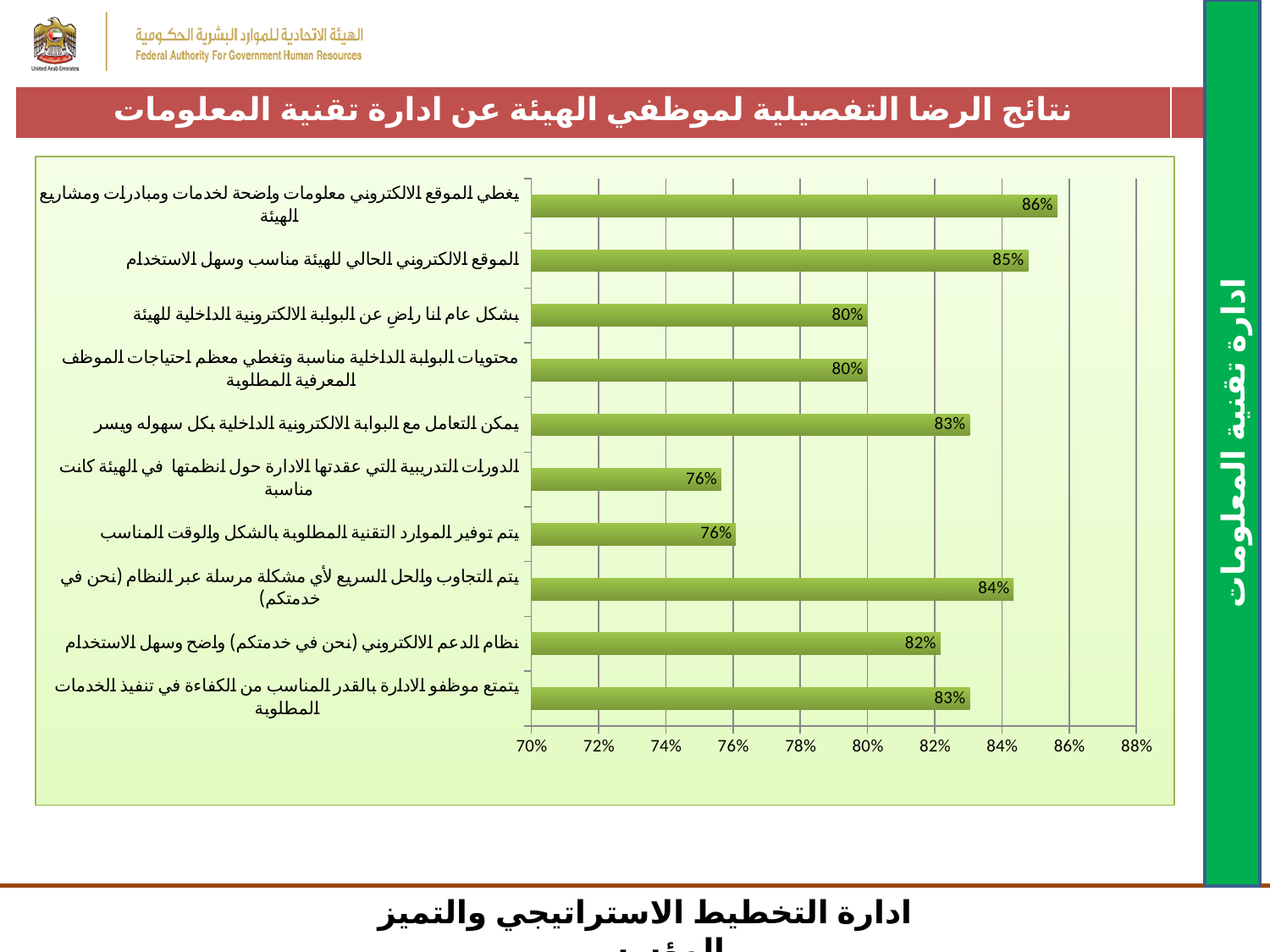
What is the difference between the value for "يغطي الموقع الالكتروني معلومات واضحة لخدمات ومبادرات ومشاريع الهيئة" and the value for "يتم توفير الموارد التقنية المطلوبة بالشكل والوقت المناسب"? 10% Which is larger: the value for "يمكن التعامل مع البوابة الالكترونية الداخلية بكل سهوله ويسر" or the value for "نظام الدعم الالكتروني (نحن في خدمتكم) واضح وسهل الاستخدام"? يمكن التعامل مع البوابة الالكترونية الداخلية بكل سهوله ويسر Is the value for "الدورات التدريبية التي عقدتها الادارة حول انظمتها في الهيئة كانت مناسبة" greater or less than 80%? less What is the value for "نظام الدعم الالكتروني (نحن في خدمتكم) واضح وسهل الاستخدام"? 82% What is the value for "يتم التجاوب والحل السريع لأي مشكلة مرسلة عبر النظام (نحن في خدمتكم)"? 84% What is the lowest value shown in the chart? 76% Which category has the highest value? يغطي الموقع الالكتروني معلومات واضحة لخدمات ومبادرات ومشاريع الهيئة What is the value for "الموقع الالكتروني الحالي للهيئة مناسب وسهل الاستخدام"? 85% What is the value for "بشكل عام انا راضٍ عن البوابة الالكترونية الداخلية للهيئة"? 80% How many categories (bars) does the chart show? 10 What is the title of the chart slide? نتائج الرضا التفصيلية لموظفي الهيئة عن ادارة تقنية المعلومات What type of chart is shown on the slide? bar chart